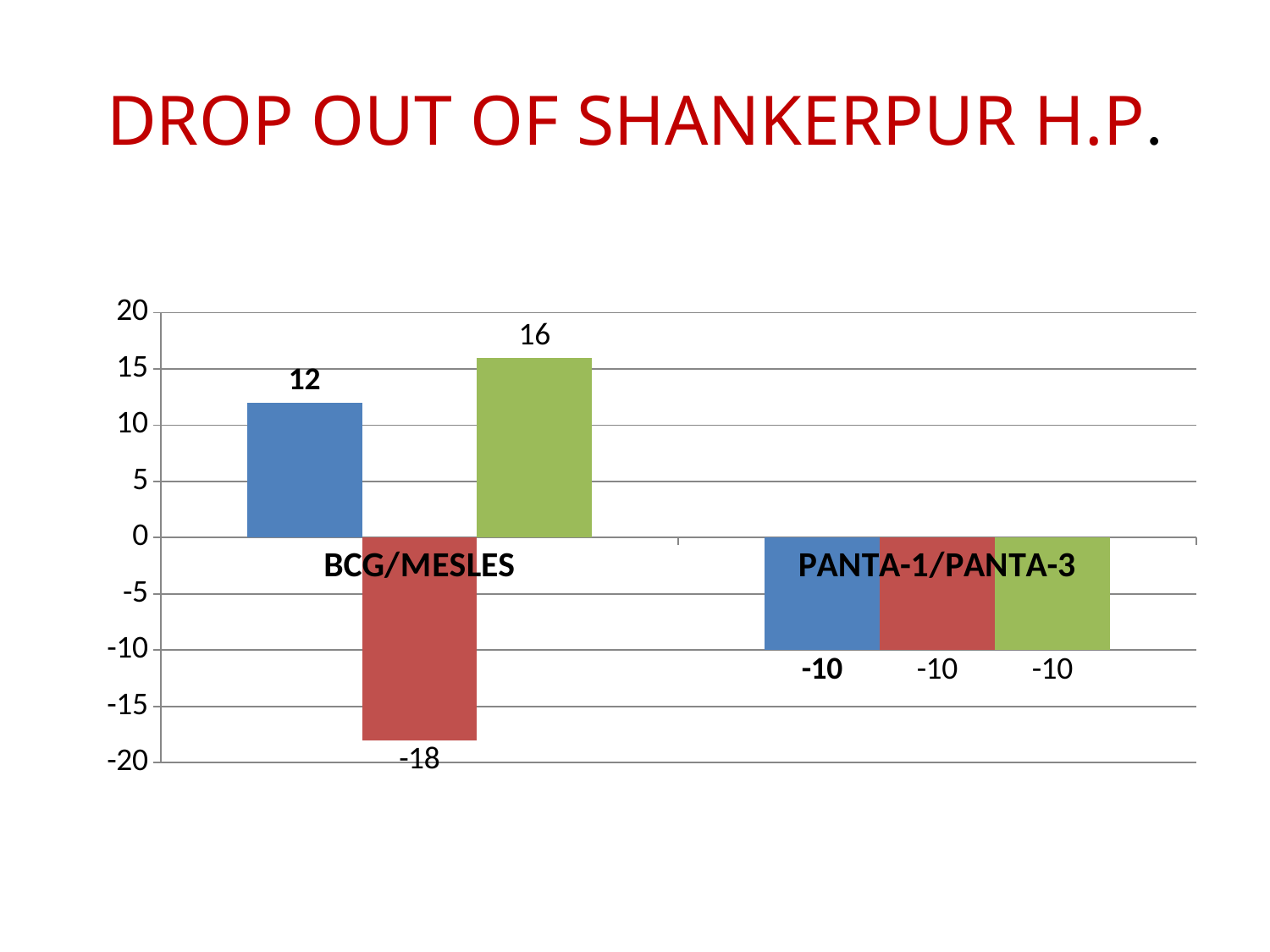
Which bar has the highest value on the chart? The green bar for BCG/MESLES (16) Which is larger for BCG/MESLES, the blue bar or the green bar? The green bar What is the value of the green bar for PANTA-1/PANTA-3? -10 What is the value of the blue bar for BCG/MESLES? 12 What is the difference between the green bar and the blue bar for BCG/MESLES? 4 What is the title of the slide? DROP OUT OF SHANKERPUR H.P. What kind of chart is shown on the slide? Bar chart What is the value of the green bar for BCG/MESLES? 16 What is the value of the red bar for BCG/MESLES? -18 Which bar has the lowest value on the chart? The red bar for BCG/MESLES (-18) What is the value of the blue bar for PANTA-1/PANTA-3? -10 How many categories are shown on the x axis? 2